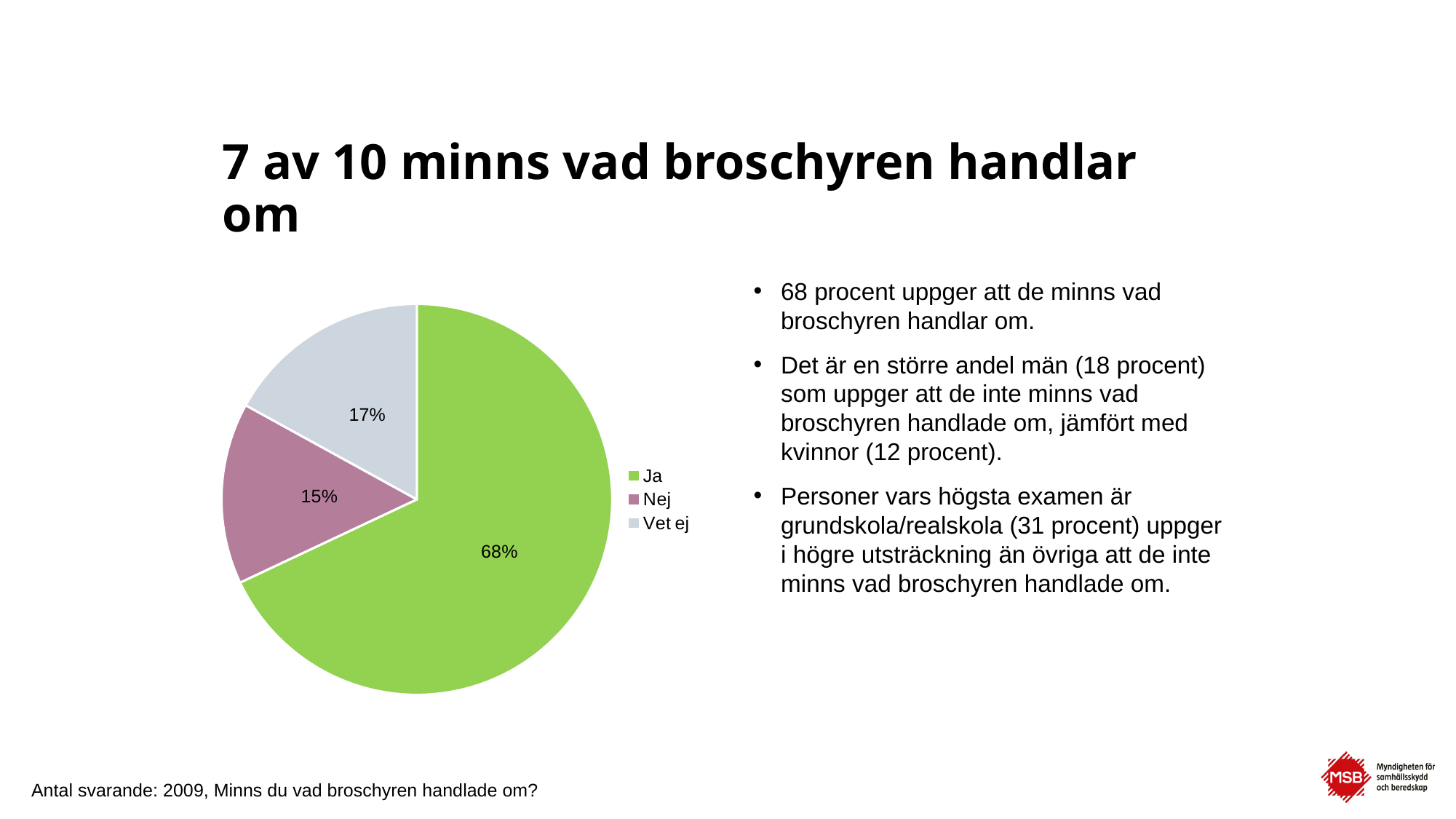
Which category has the smallest slice of the pie? Nej What share of the pie does the "Ja" slice represent? 68% What kind of chart is shown on the slide? Pie chart How many slices does the pie chart have? 3 What is the difference in percentage points between the "Ja" slice and the "Vet ej" slice? 51 What is the difference in percentage points between the "Vet ej" slice and the "Nej" slice? 2 What colour is the "Ja" slice in the pie chart? Green Which category has the largest slice of the pie? Ja How many entries does the legend list? 3 What share of the pie does the "Nej" slice represent? 15% What share of the pie does the "Vet ej" slice represent? 17% Which slice is larger, "Ja" or "Nej"? Ja